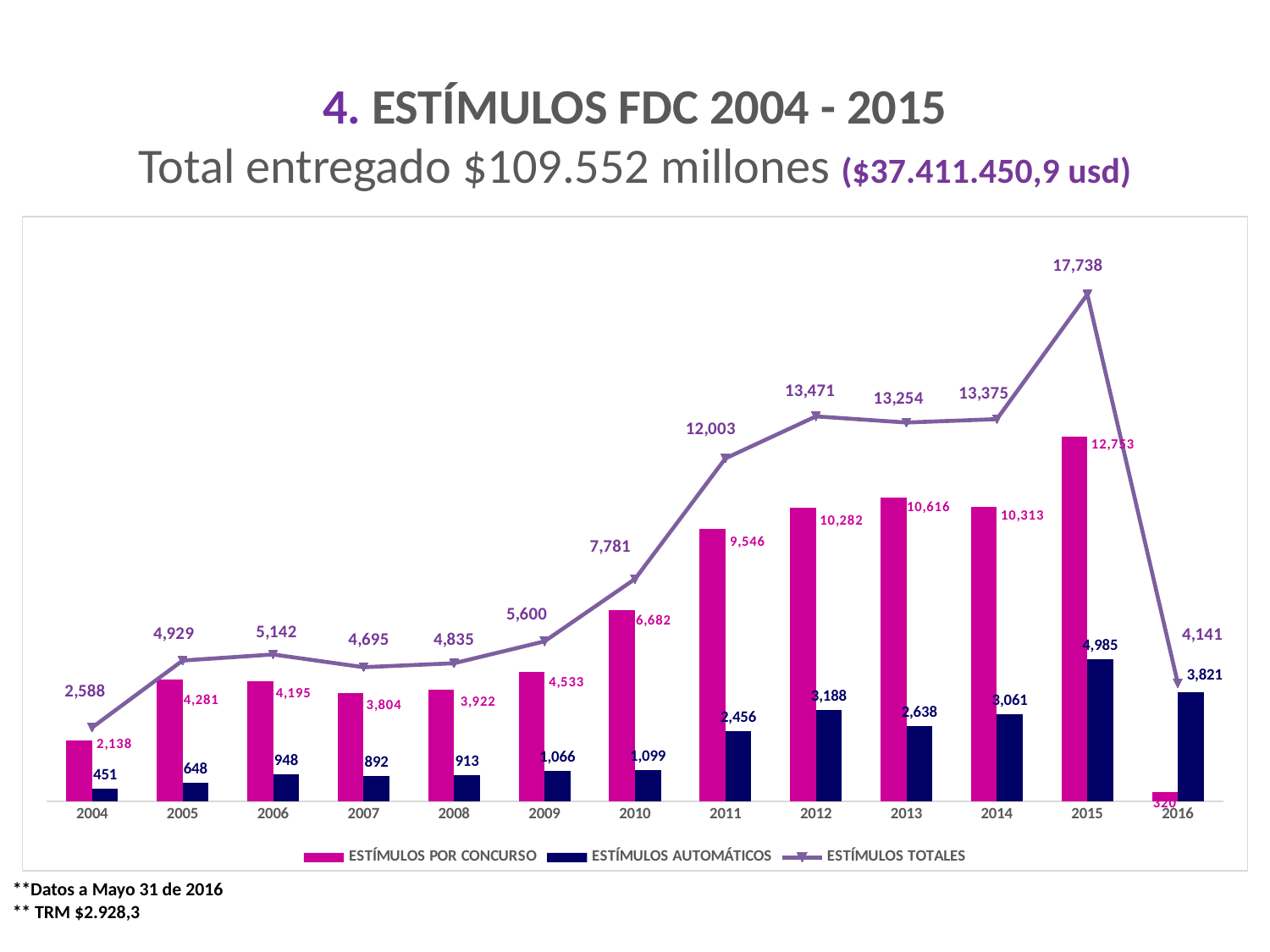
In which year is ESTÍMULOS POR CONCURSO lowest? 2016 What is the difference between ESTÍMULOS TOTALES in 2015 and in 2014? 4,363 How many years are shown on the x axis? 13 What is the value of ESTÍMULOS POR CONCURSO in 2011? 9,546 In which year is ESTÍMULOS TOTALES highest? 2015 Does ESTÍMULOS AUTOMÁTICOS rise or fall from 2004 to 2015? Rise What kind of chart is this? Combined bar and line chart How many series does the legend list? 3 Which is larger in 2016: ESTÍMULOS POR CONCURSO or ESTÍMULOS AUTOMÁTICOS? ESTÍMULOS AUTOMÁTICOS What is the value of ESTÍMULOS TOTALES in 2010? 7,781 Which series is shown as a line with markers? ESTÍMULOS TOTALES What is the value of ESTÍMULOS AUTOMÁTICOS in 2012? 3,188